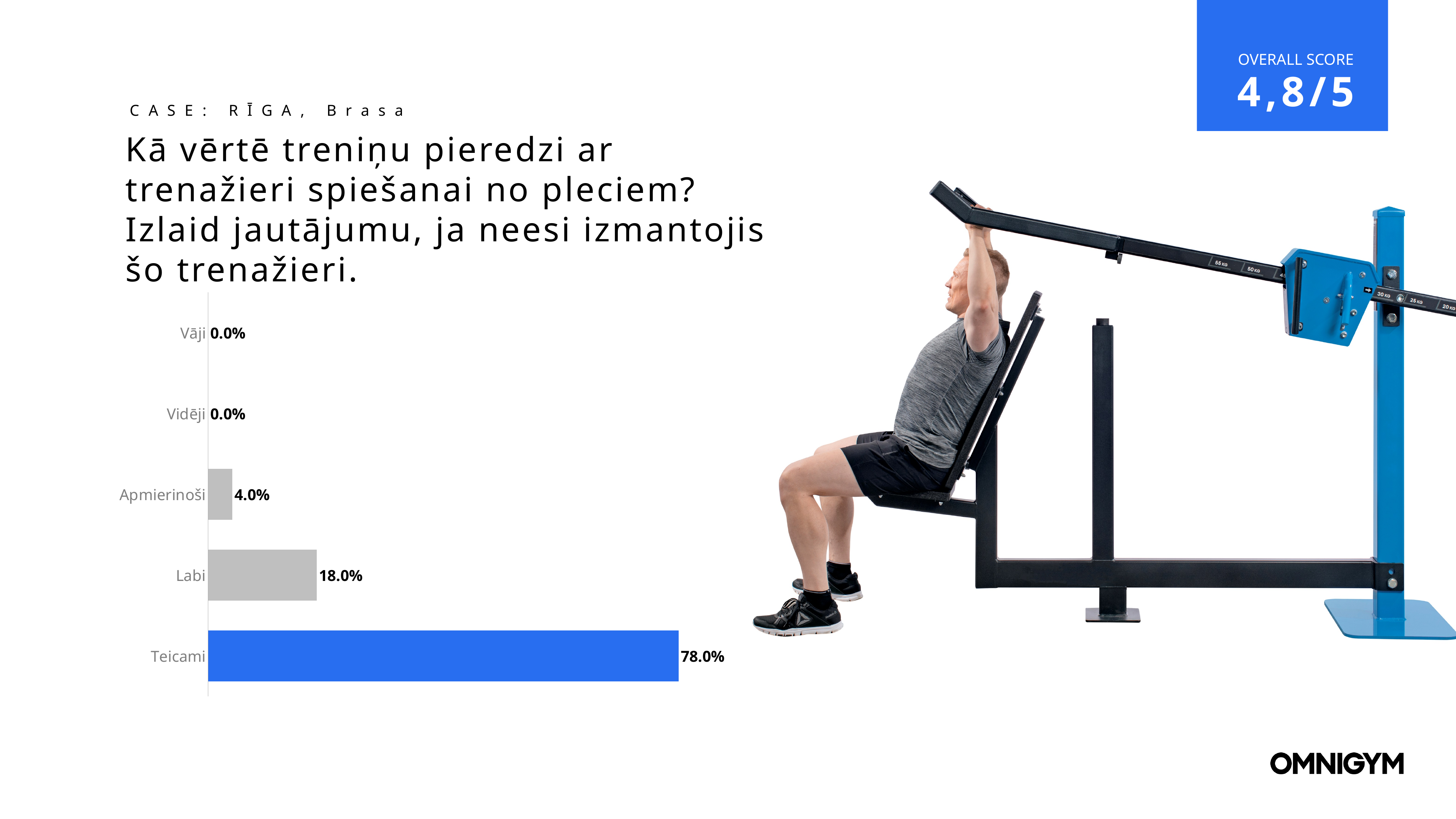
What is the combined value of Teicami and Labi? 96.0% What is the value for Teicami? 78.0% What is the value for Labi? 18.0% What is the value for Vāji? 0.0% What is the value for Apmierinoši? 4.0% How many categories does the chart show? 5 What is the difference between the values for Labi and Apmierinoši? 14.0% Which category has the highest value? Teicami What is the difference between the values for Teicami and Labi? 60.0% Which is larger, the value for Labi or the value for Apmierinoši? Labi Which bar is coloured blue rather than grey? Teicami What kind of chart is shown on the slide? bar chart